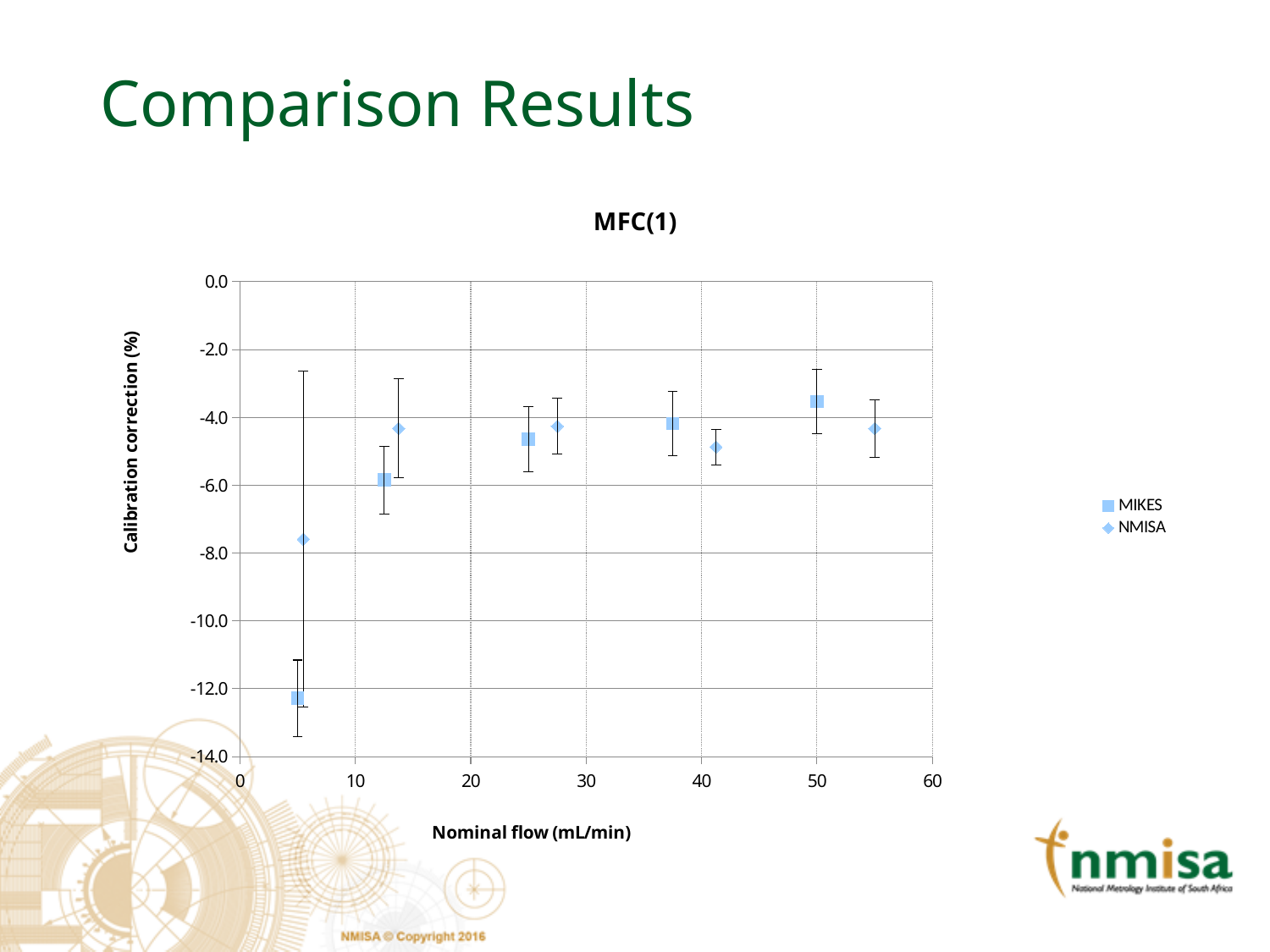
What kind of chart is shown on the slide? scatter chart Is the MIKES value at the lowest nominal flow greater or less than -10.0? less Is the NMISA value at a nominal flow of about 41 mL/min greater or less than -4.0? less How many MIKES data points are plotted? 5 Which series has the lowest plotted calibration correction on the chart? MIKES Is the MIKES value at a nominal flow of 50 mL/min greater or less than -4.0? greater Do the MIKES values rise or fall as nominal flow increases? rise How many NMISA data points are plotted? 5 What is the label of the x axis? Nominal flow (mL/min) What is the title of the chart? MFC(1) How many series does the legend list? 2